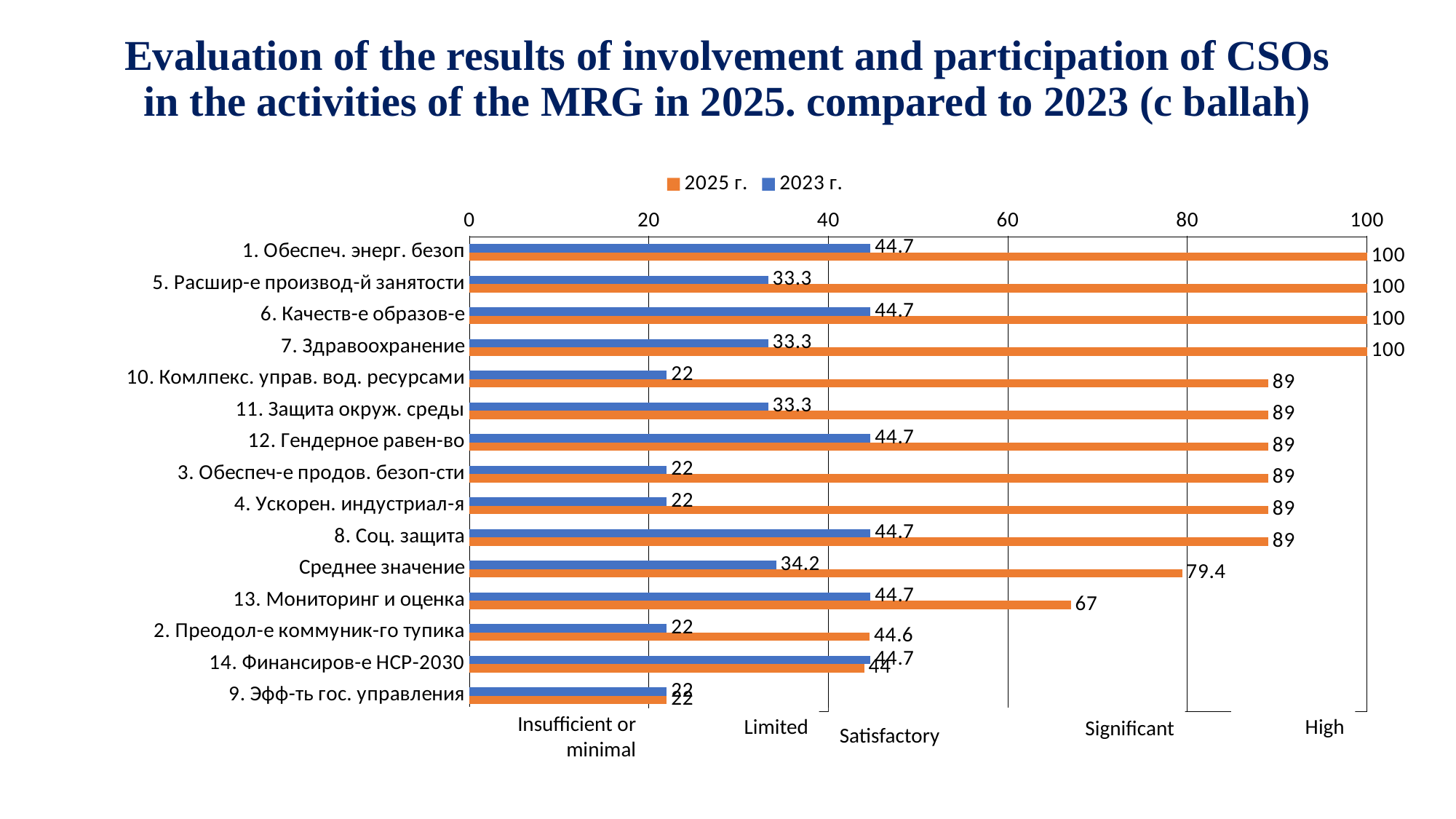
What is the 2025 г. value for Среднее значение? 79.4 What is the 2025 г. value for 13. Мониторинг и оценка? 67 What is the 2023 г. value for 7. Здравоохранение? 33.3 Is the 2025 г. value for 13. Мониторинг и оценка greater or less than 60? greater What is the difference between the 2025 г. and 2023 г. values for Среднее значение? 45.2 What type of chart is shown on the slide? Bar chart How many series does the legend list? 2 How many categories are shown on the chart? 15 What is the difference between the 2025 г. and 2023 г. values for 10. Комлпекс. управ. вод. ресурсами? 67 Which category has the lowest 2025 г. value? 9. Эфф-ть гос. управления What is the 2025 г. value for 2. Преодол-е коммуник-го тупика? 44.6 Which is larger for 14. Финансиров-е НСР-2030: the 2023 г. value or the 2025 г. value? 2023 г.